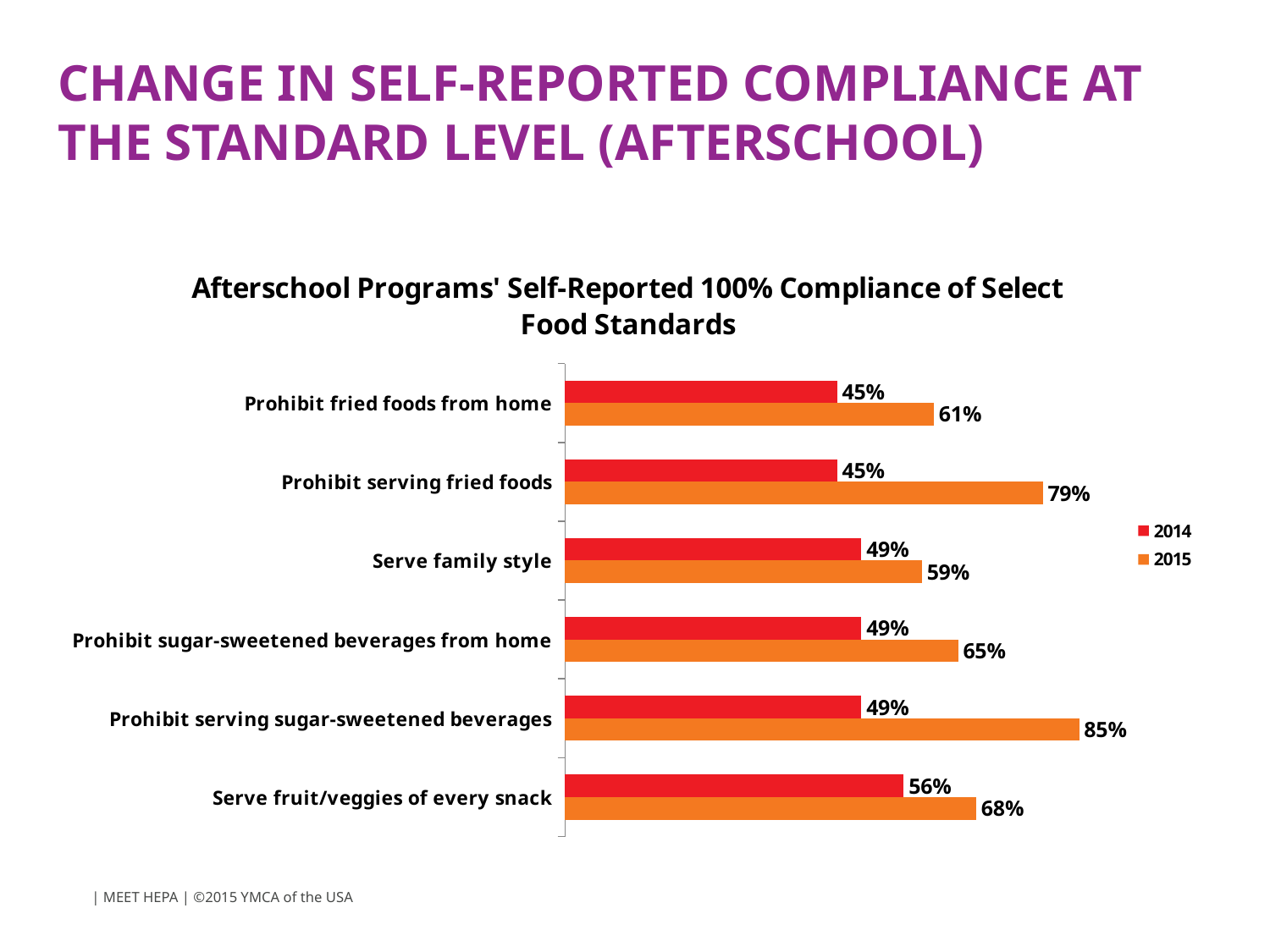
What is the 2015 value for Serve family style? 59% Which category has the highest 2015 value? Prohibit serving sugar-sweetened beverages Which category has the lowest 2015 value? Serve family style How many series does the legend list? 2 What is the 2015 value for Prohibit serving sugar-sweetened beverages? 85% Which category has the highest 2014 value? Serve fruit/veggies of every snack Which is larger: the 2015 value for Prohibit fried foods from home or the 2015 value for Prohibit sugar-sweetened beverages from home? Prohibit sugar-sweetened beverages from home What is the difference between the 2015 and 2014 values for Prohibit serving fried foods? 34% How many categories are shown on the chart? 6 What is the title of the chart? Afterschool Programs' Self-Reported 100% Compliance of Select Food Standards What kind of chart is shown on the slide? Bar chart What is the 2014 value for Serve fruit/veggies of every snack? 56%